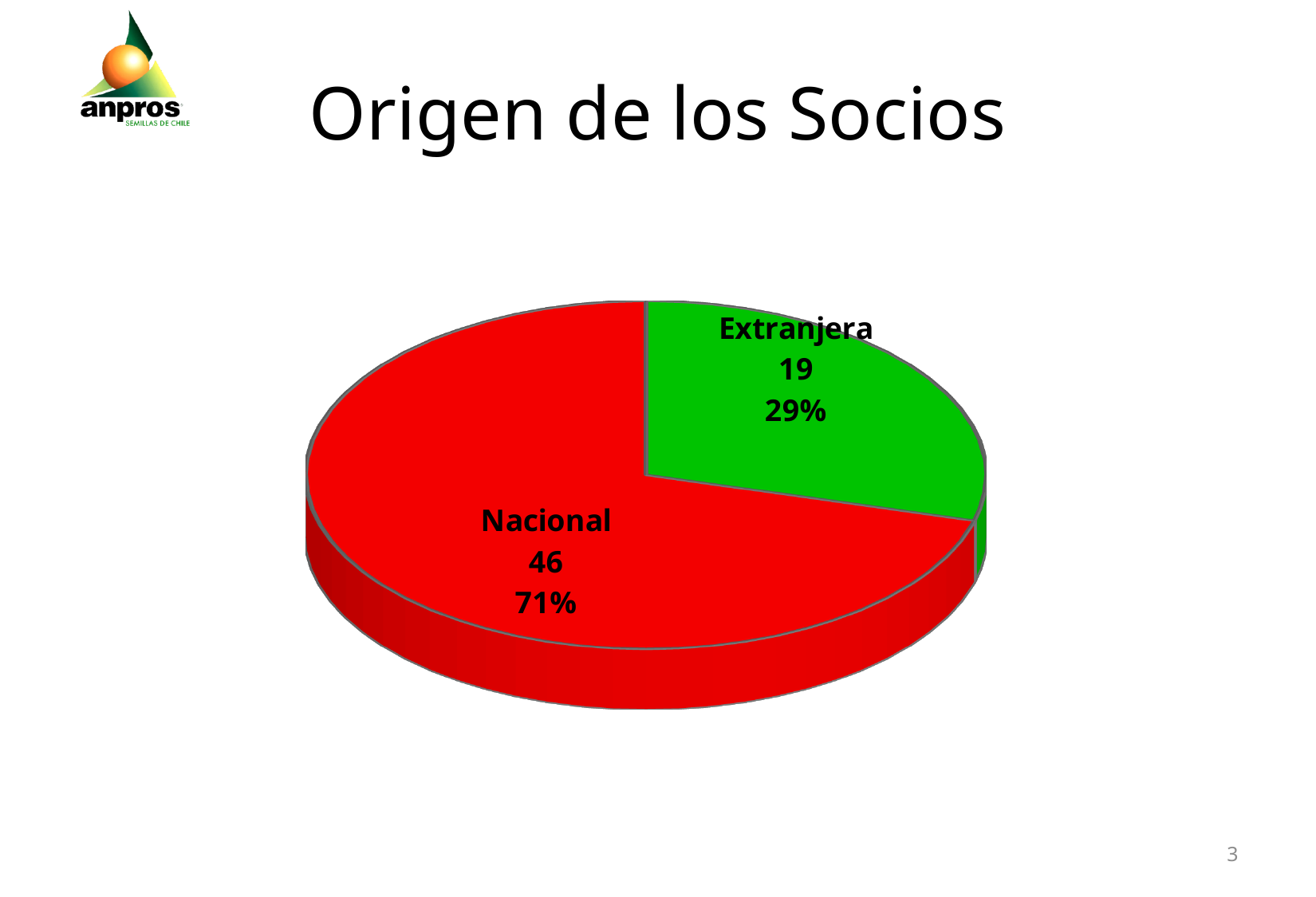
What share of the pie does Extranjera represent? 29% Which category has the smallest slice? Extranjera What is the value for Extranjera? 19 What is the total of the two slices? 65 Which category has the largest slice? Nacional What share of the pie does Nacional represent? 71% What is the title of the chart? Origen de los Socios What is the difference between the values for Nacional and Extranjera? 27 What kind of chart is shown on the slide? pie chart What is the value for Nacional? 46 Which is larger, Nacional or Extranjera? Nacional How many slices does the pie chart have? 2